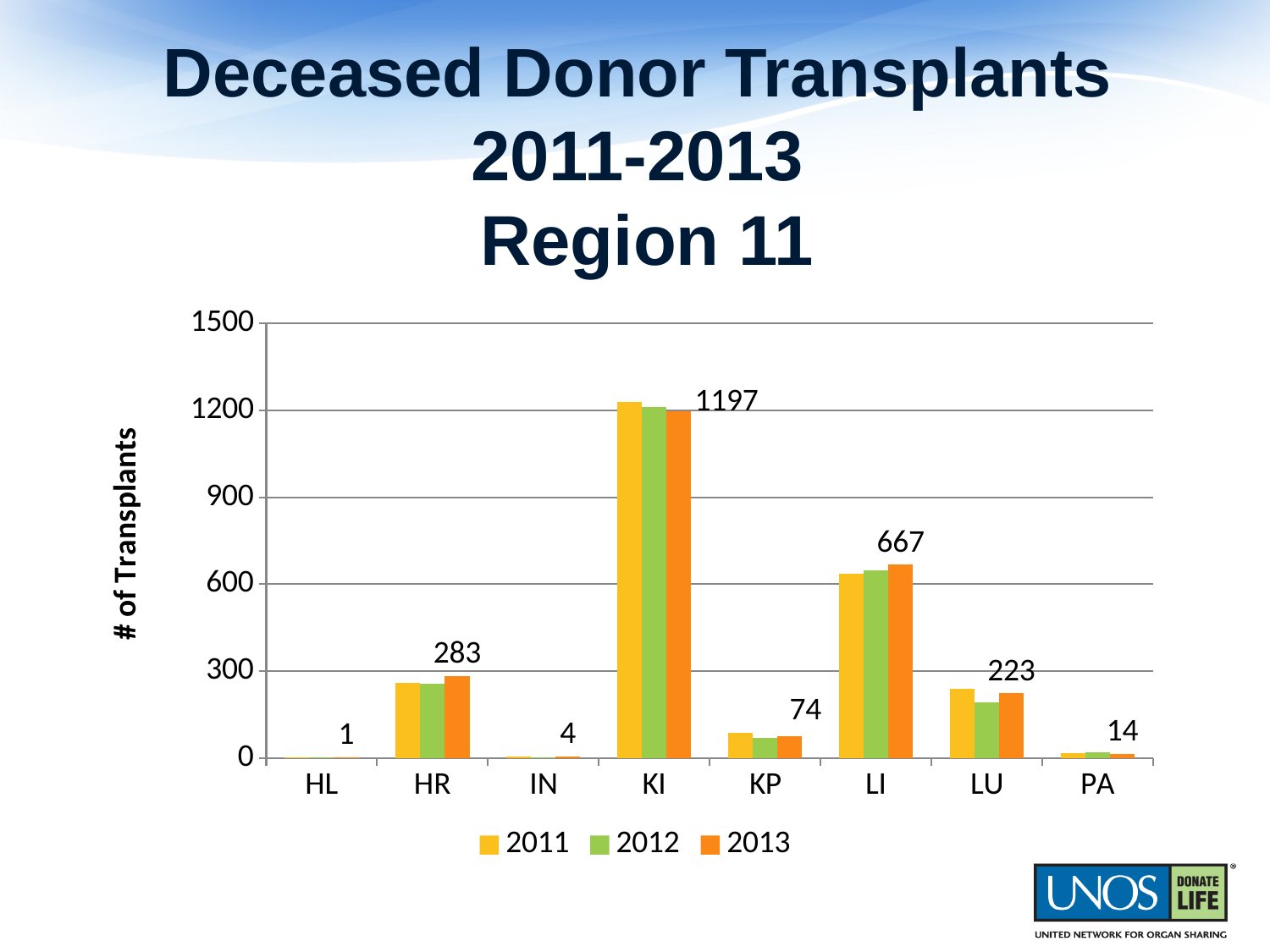
What is the difference between the 2013 values for KI and LI? 530 What is the value for KI in 2013? 1197 Which is larger in 2013, the value for LU or the value for KP? LU What kind of chart is shown on the slide? bar chart What is the value for LI in 2013? 667 Is the value for LI in 2011 greater or less than 900? less What is the value for HR in 2013? 283 Which category has the highest number of transplants in 2013? KI How many series does the legend list? 3 What is the value for PA in 2013? 14 How many categories are shown on the x axis? 8 Which category has the lowest number of transplants in 2013? HL